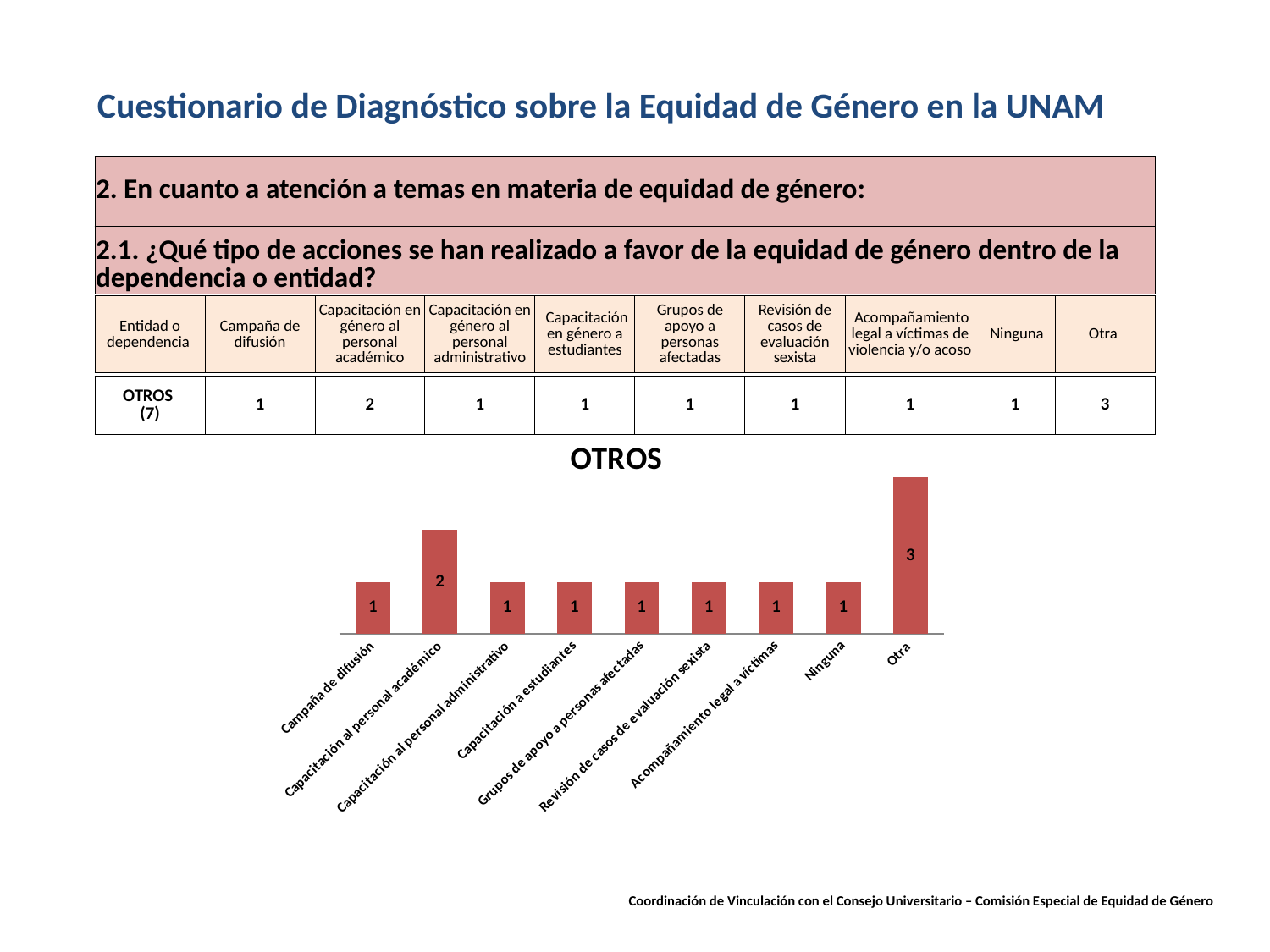
Which category has the highest value in the OTROS chart? Otra What is the difference between the values for "Otra" and "Capacitación al personal académico" in the OTROS chart? 1 Which is larger in the OTROS chart: "Capacitación al personal académico" or "Capacitación a estudiantes"? Capacitación al personal académico What is the value for "Ninguna" in the OTROS chart? 1 How many categories are shown in the OTROS chart? 9 What is the value for "Campaña de difusión" in the OTROS chart? 1 What is the value for "Otra" in the OTROS chart? 3 What is the value for "Capacitación al personal académico" in the OTROS chart? 2 What is the difference between the values for "Otra" and "Ninguna" in the OTROS chart? 2 What kind of chart is the OTROS chart? bar chart What is the title of the chart on the slide? OTROS How many categories in the OTROS chart have a value of 1? 7